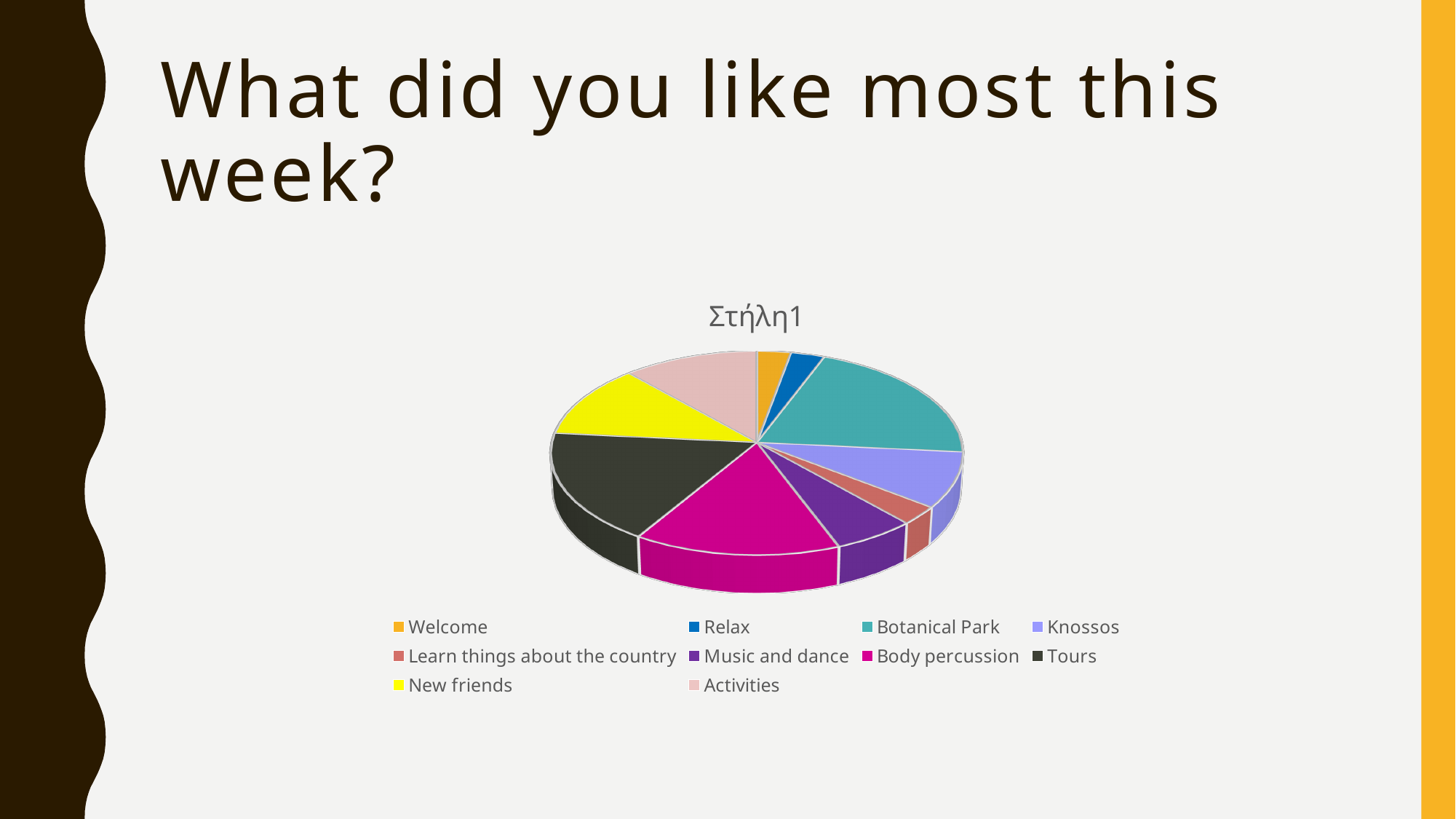
Which slice is larger, Body percussion or Welcome? Body percussion What is the title shown above the pie chart? Στήλη1 Which slice is larger, New friends or Relax? New friends Which slice is larger, Botanical Park or Relax? Botanical Park How many categories does the pie chart show? 10 What kind of chart is shown on the slide? Pie chart Which category is shown in yellow in the pie chart? New friends What colour represents Body percussion in the pie chart? Magenta